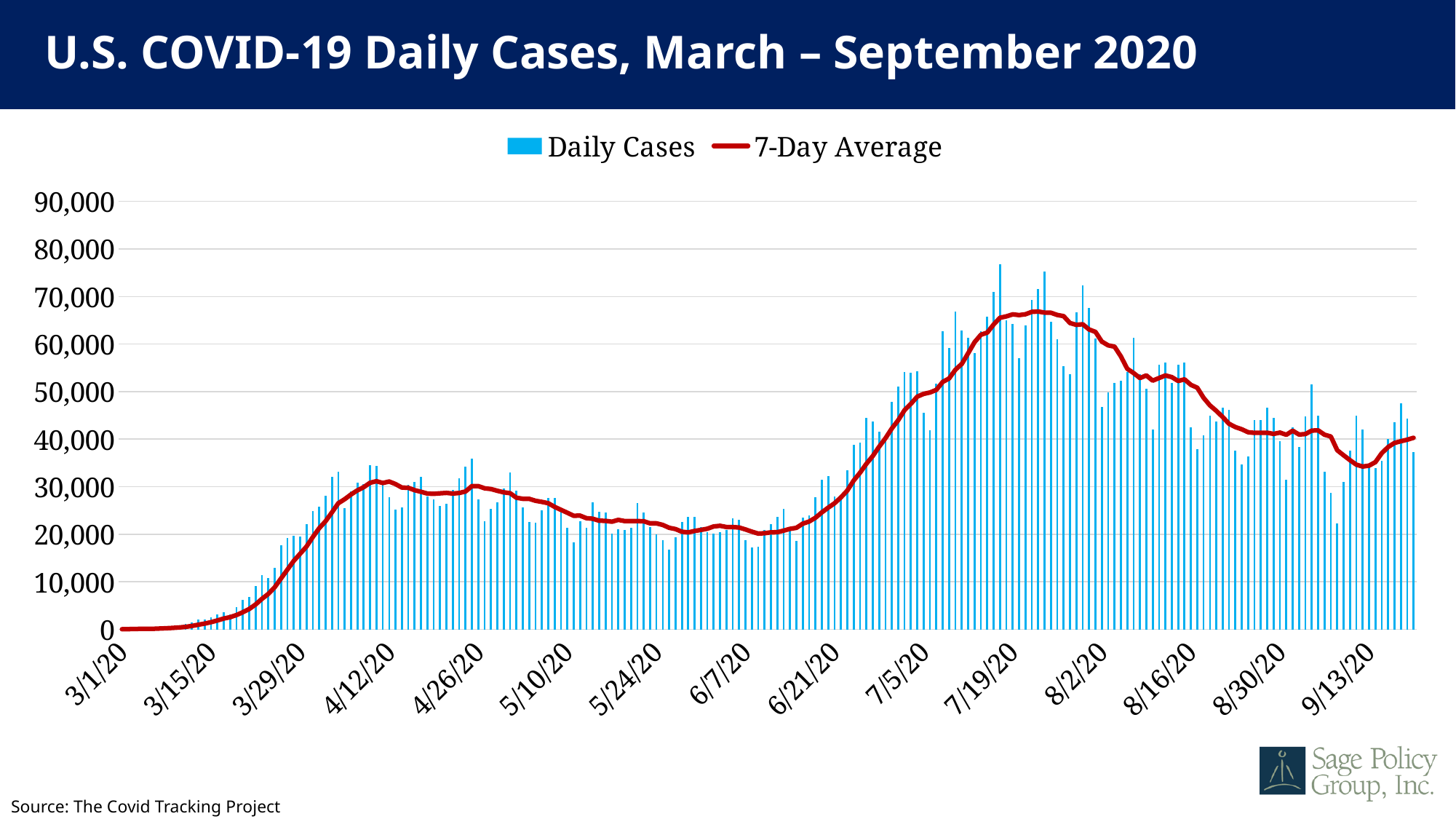
Among the dates labelled on the x axis, which has the highest 7-Day Average? 7/19/20 Is the 7-Day Average on 6/7/20 greater or less than 30,000? less Is the 7-Day Average on 7/19/20 greater or less than 60,000? greater What are the two series named in the legend? Daily Cases and 7-Day Average Which of the labelled dates, 4/12/20 or 7/19/20, has the higher 7-Day Average? 7/19/20 Is the highest Daily Cases bar on the chart greater or less than 80,000? less How many series does the legend list? 2 What kind of chart is shown on the slide? A combined bar and line chart Does the 7-Day Average rise or fall between 7/19/20 and 8/30/20? fall What is the source cited for the chart? The Covid Tracking Project Does the 7-Day Average rise or fall between 6/7/20 and 7/19/20? rise